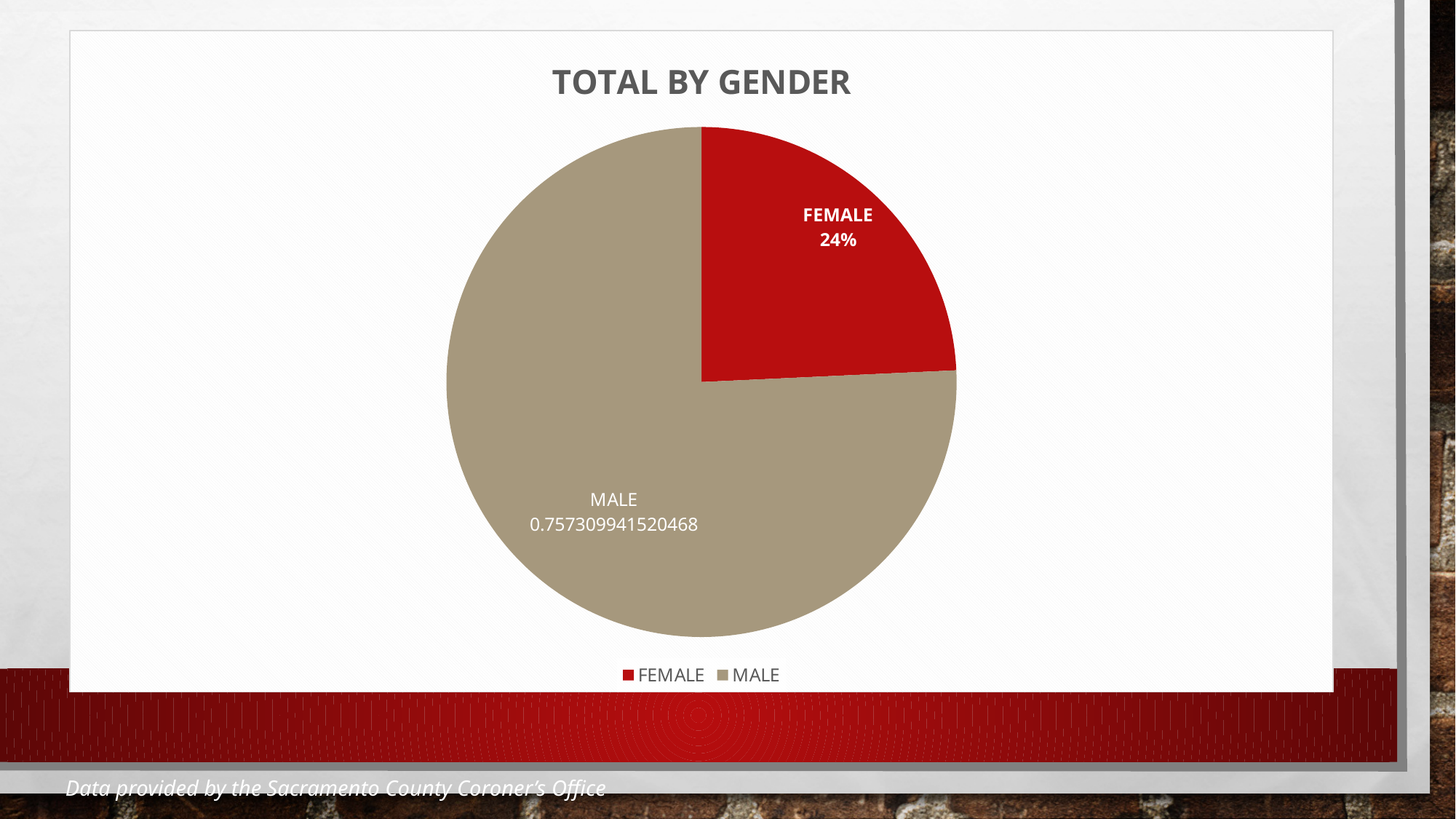
Which slice is the smallest? FEMALE What is the title of the chart? TOTAL BY GENDER What value is printed on the MALE slice? 0.757309941520468 What percentage is shown for the FEMALE slice? 24% How many slices does the pie chart have? 2 What kind of chart is shown on the slide? pie chart What share of the pie does the FEMALE slice represent? 24% How many entries does the legend list? 2 Which slice is the largest? MALE Which is larger, the MALE slice or the FEMALE slice? MALE What colour is the FEMALE slice? red